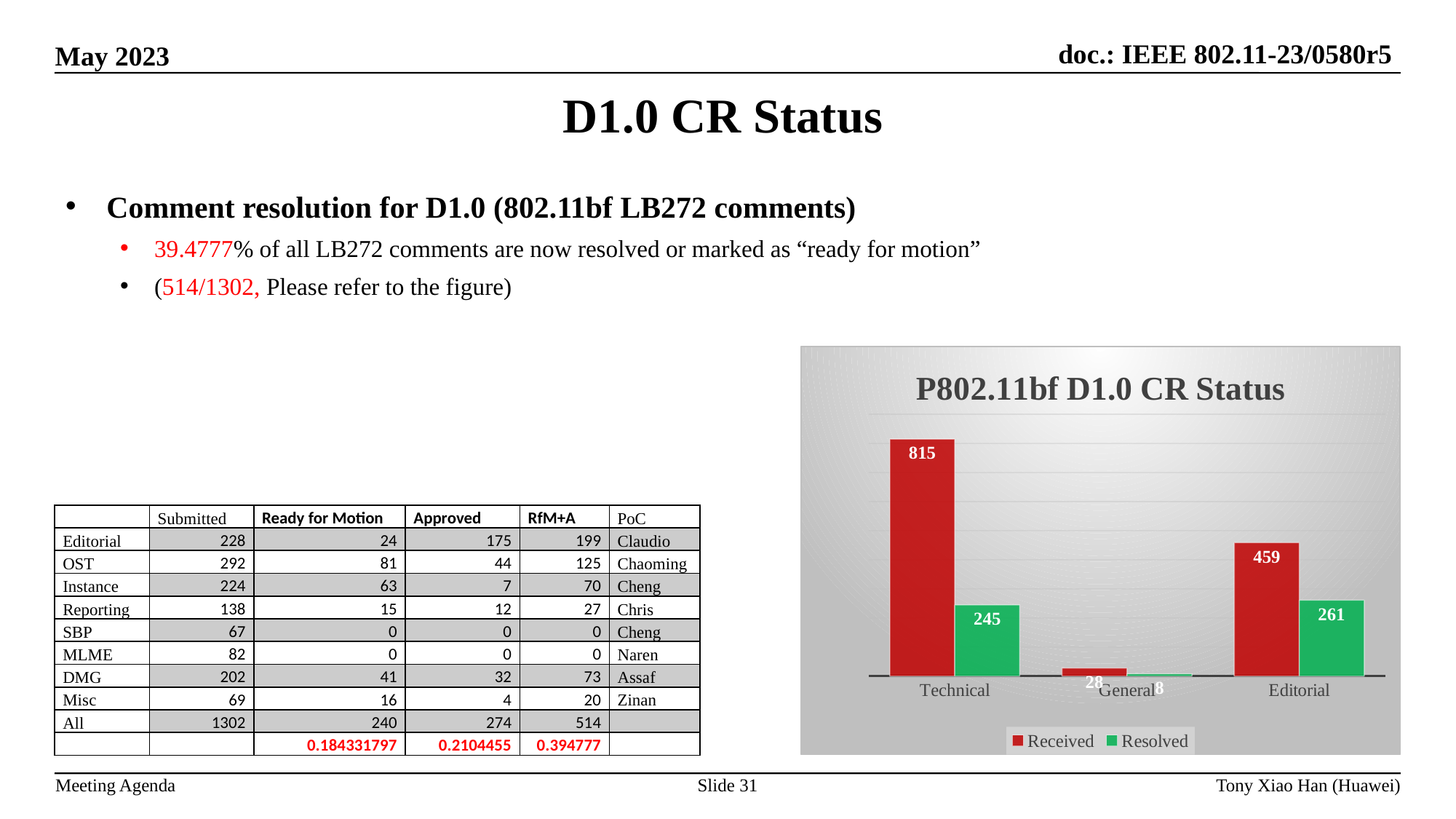
How many series does the chart legend list? 2 Which is larger, the Resolved value for Editorial or the Resolved value for Technical? Editorial What is the title of the chart? P802.11bf D1.0 CR Status What is the Received value for Technical? 815 What is the Received value for General? 28 What is the Resolved value for Editorial? 261 What is the difference between the Received and Resolved values for Technical? 570 Which category has the highest Received value? Technical Which category has the lowest Resolved value? General Which colour represents the Resolved series in the chart? green How many categories are shown on the x axis of the chart? 3 What type of chart is shown on the slide? bar chart